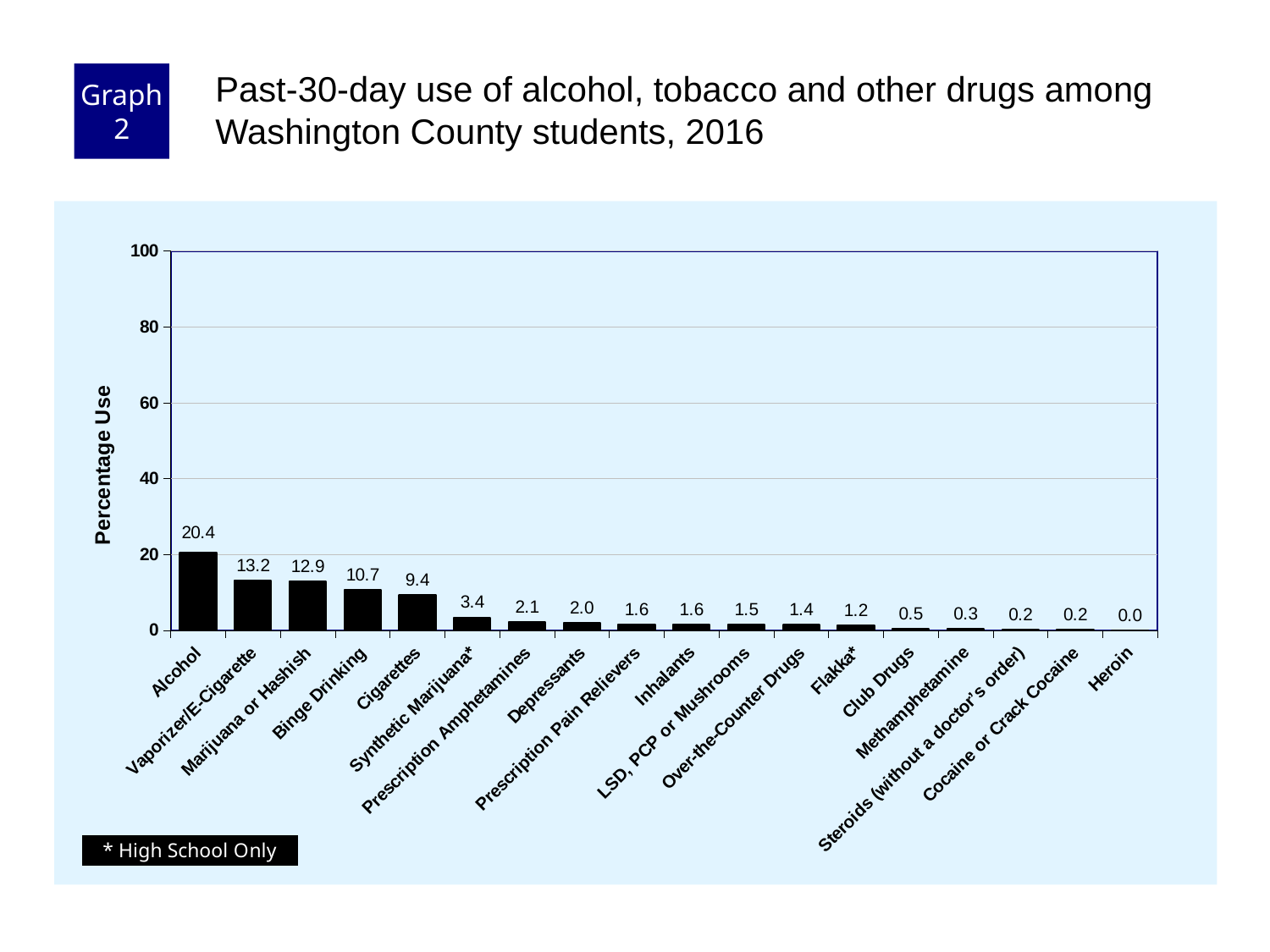
What is the percentage use for Synthetic Marijuana*? 3.4 What is the percentage use for Binge Drinking? 10.7 Which has a higher percentage use, Binge Drinking or Cigarettes? Binge Drinking Which category has the highest percentage use? Alcohol How many categories are shown on the x axis? 18 What is the difference in percentage use between Vaporizer/E-Cigarette and Marijuana or Hashish? 0.3 Which category has the lowest percentage use? Heroin What kind of chart is shown on the slide? Bar chart What is the percentage use for Alcohol? 20.4 What is the difference in percentage use between Alcohol and Cigarettes? 11.0 What is the percentage use for Heroin? 0.0 Is the value for Alcohol greater or less than 40? less